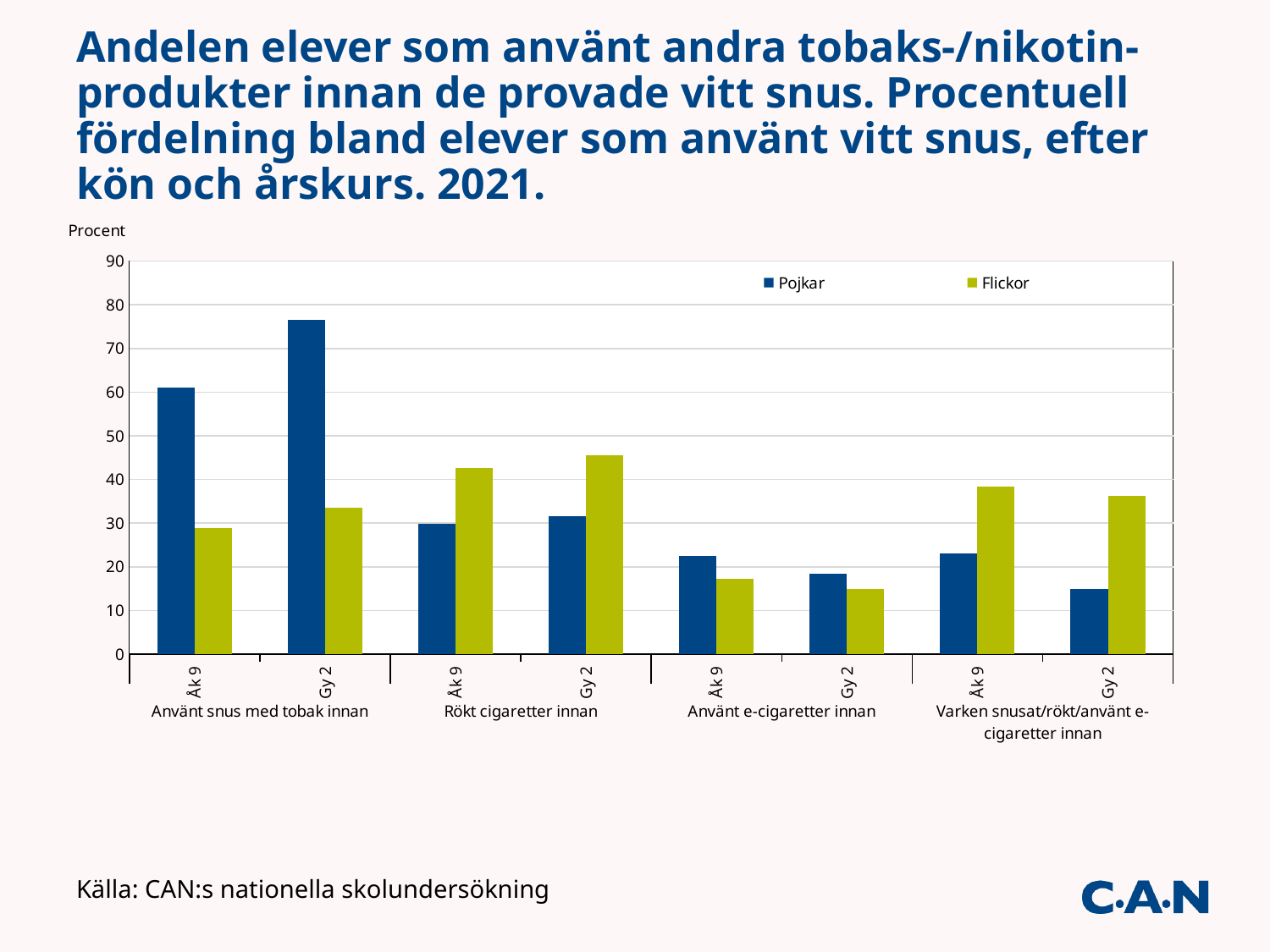
Under 'Använt e-cigaretter innan' for Åk 9, which is larger: Pojkar or Flickor? Pojkar Is the value for Flickor in Åk 9 under 'Varken snusat/rökt/använt e-cigaretter innan' greater or less than 30? greater Under 'Rökt cigaretter innan' for Gy 2, which is larger: Pojkar or Flickor? Flickor What label is shown above the vertical axis? Procent Is the value for Pojkar in Åk 9 under 'Rökt cigaretter innan' greater or less than 40? less What are the two series named in the legend? Pojkar and Flickor Is the value for Pojkar in Gy 2 under 'Använt snus med tobak innan' greater or less than 70? greater What kind of chart is shown on the slide? Bar chart Which bar is the highest in the chart? Pojkar, Gy 2, Använt snus med tobak innan How many series does the legend list? 2 How many category groups are shown along the x axis? 4